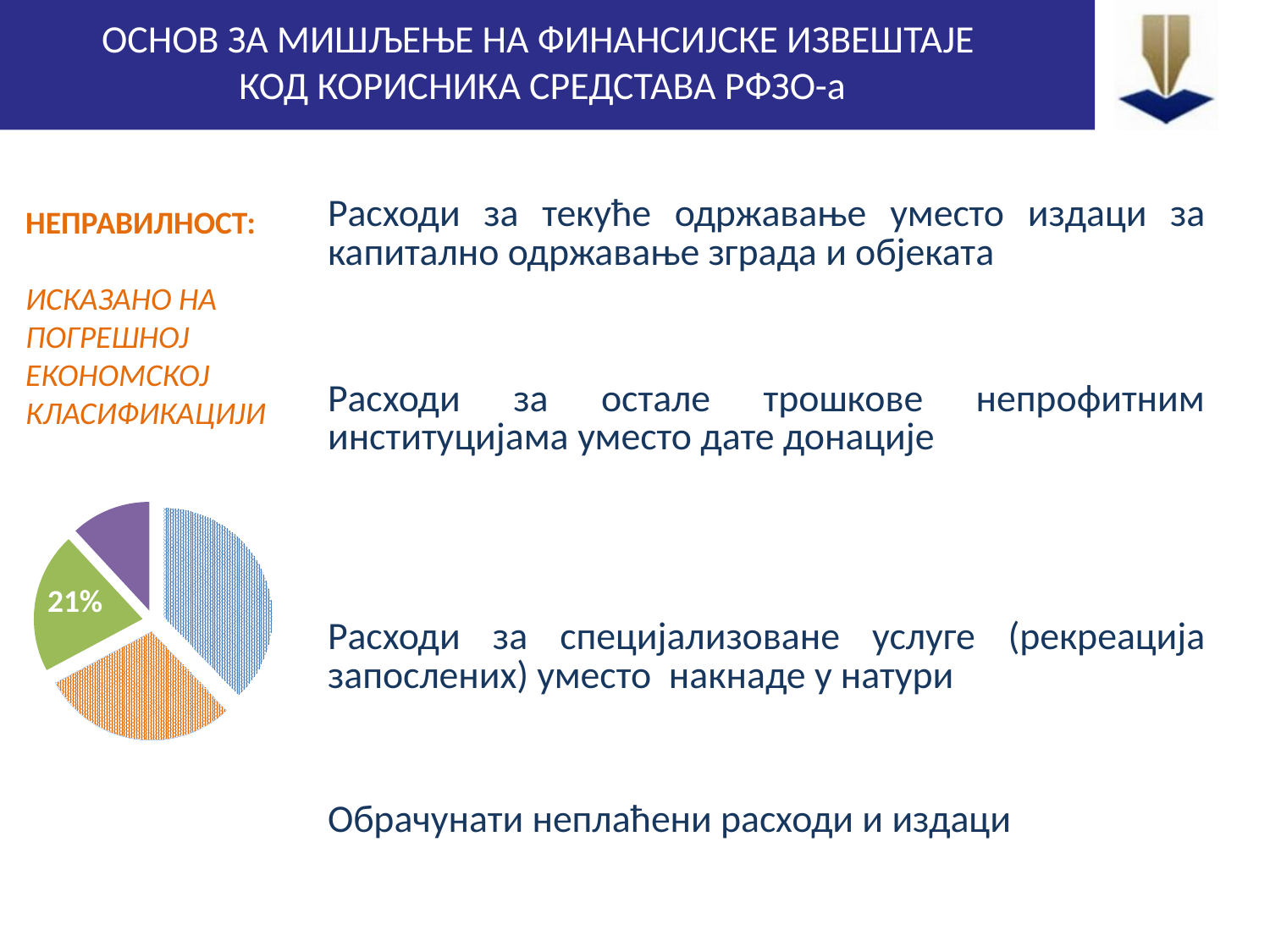
What percentage is printed on the green slice of the pie chart? 21% Which is larger in the pie chart, the blue slice or the purple slice? the blue slice Which is larger in the pie chart, the green slice or the purple slice? the green slice Which slice of the pie chart is the smallest? the purple slice Which colour slice of the pie chart carries the 21% label? green What kind of chart is shown on the slide? pie chart How many slices does the pie chart have? 4 How many slices of the pie chart have a percentage label printed on them? 1